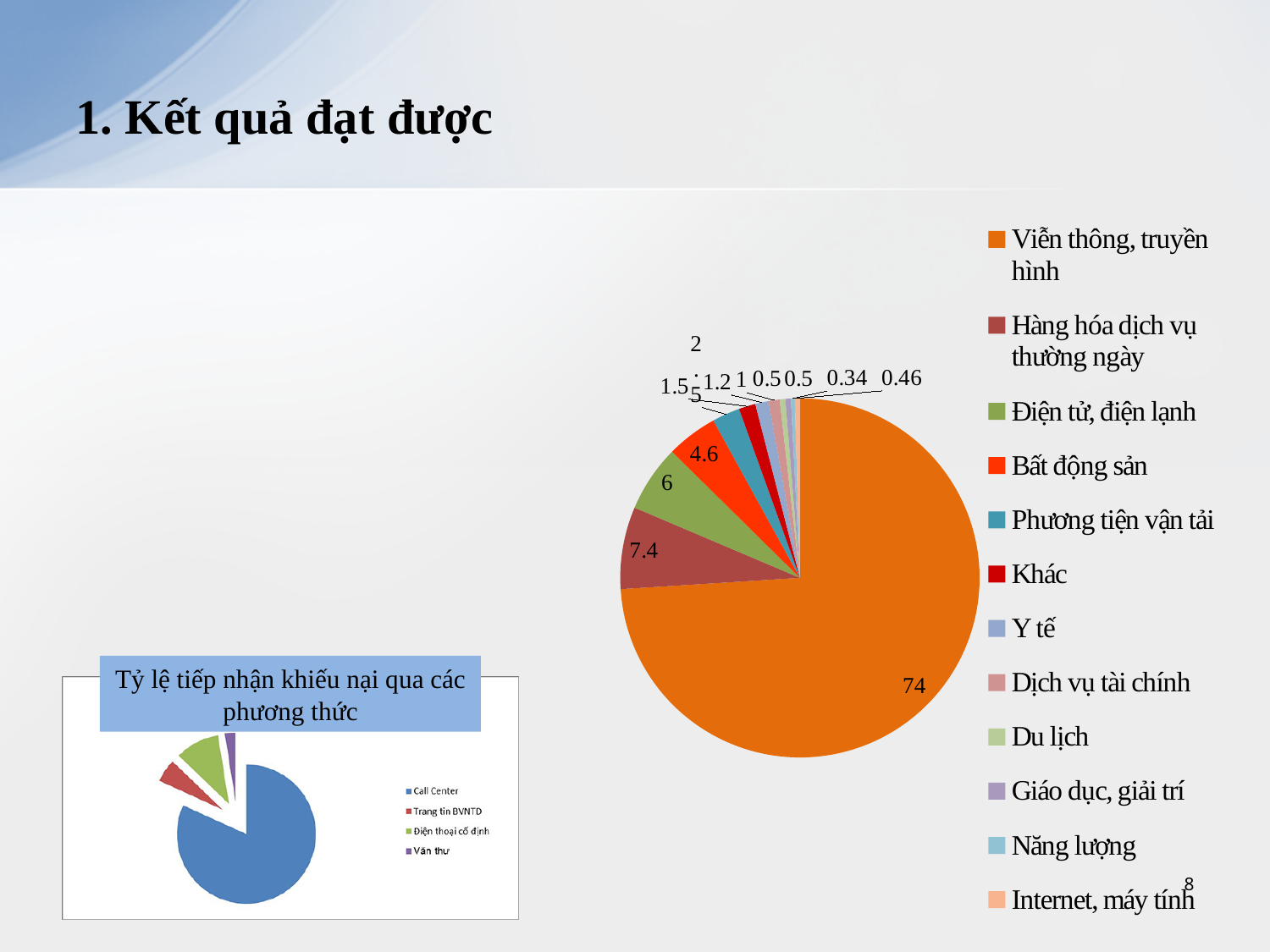
In the large pie chart on the right, what is the value for Điện tử, điện lạnh? 6 In the large pie chart on the right, how many entries does the legend list? 12 What kind of chart is the large chart on the right of the slide? pie chart In the large pie chart on the right, which category has the largest slice? Viễn thông, truyền hình In the small chart titled 'Tỷ lệ tiếp nhận khiếu nại qua các phương thức', which category has the largest slice? Call Center In the large pie chart on the right, what is the value for Bất động sản? 4.6 In the large pie chart on the right, what is the difference between the values for Hàng hóa dịch vụ thường ngày and Điện tử, điện lạnh? 1.4 In the large pie chart on the right, what is the value for Viễn thông, truyền hình? 74 In the large pie chart on the right, what is the value for Hàng hóa dịch vụ thường ngày? 7.4 In the large pie chart on the right, which is larger: Hàng hóa dịch vụ thường ngày or Điện tử, điện lạnh? Hàng hóa dịch vụ thường ngày What is the title of the small chart at the bottom left of the slide? Tỷ lệ tiếp nhận khiếu nại qua các phương thức In the large pie chart on the right, what is the difference between the values for Viễn thông, truyền hình and Hàng hóa dịch vụ thường ngày? 66.6